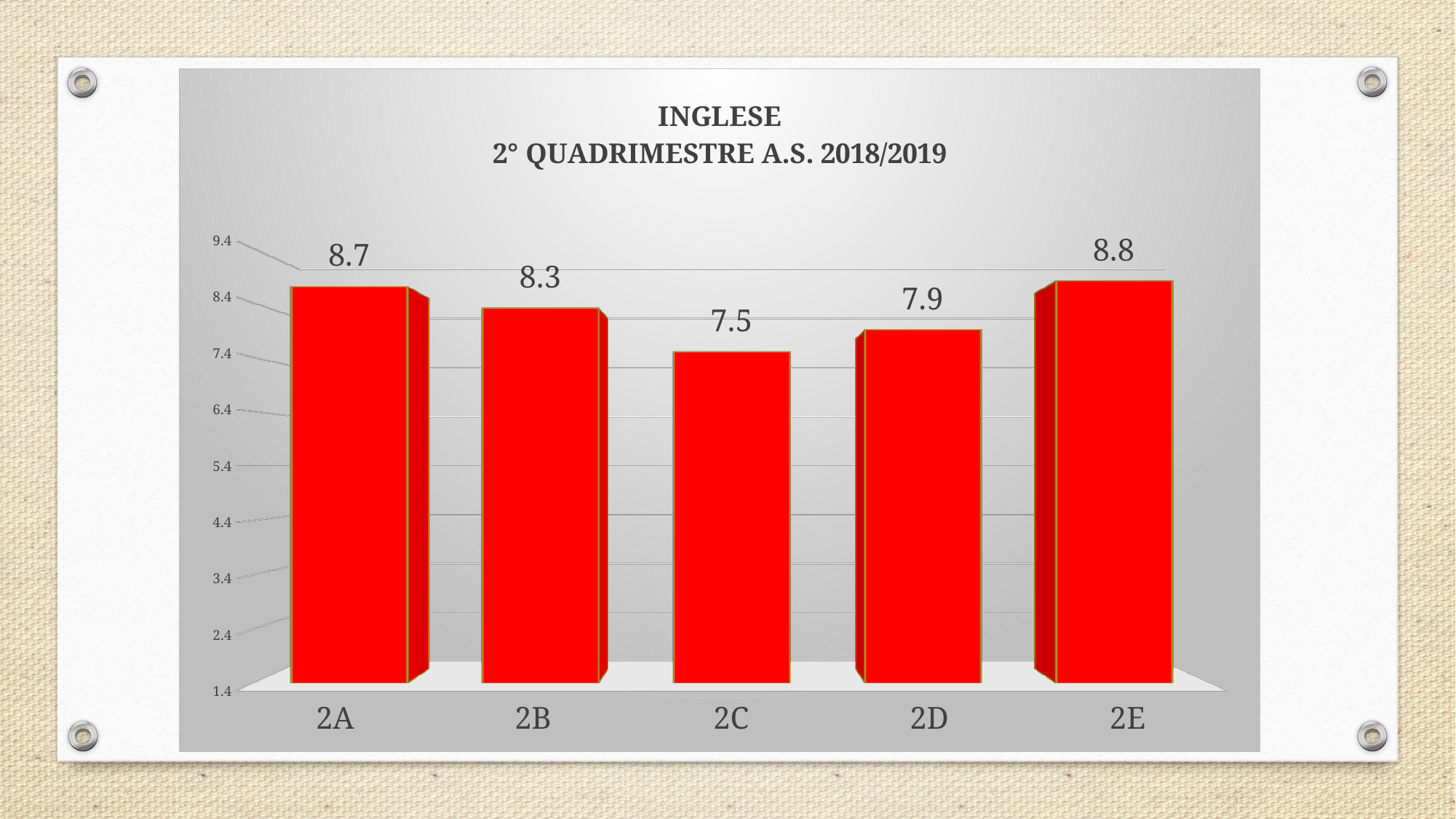
What is the title of the chart? INGLESE 2° QUADRIMESTRE A.S. 2018/2019 What is the value for class 2D? 7.9 Is the value for 2C greater or less than 8.4? less How many classes are shown on the chart? 5 What is the difference between the values for 2E and 2C? 1.3 What is the value for class 2A? 8.7 What kind of chart is shown on the slide? bar chart Which class has the lowest value? 2C What is the value for class 2C? 7.5 Which is larger, the value for 2B or the value for 2D? 2B What is the difference between the values for 2A and 2B? 0.4 Which class has the highest value? 2E